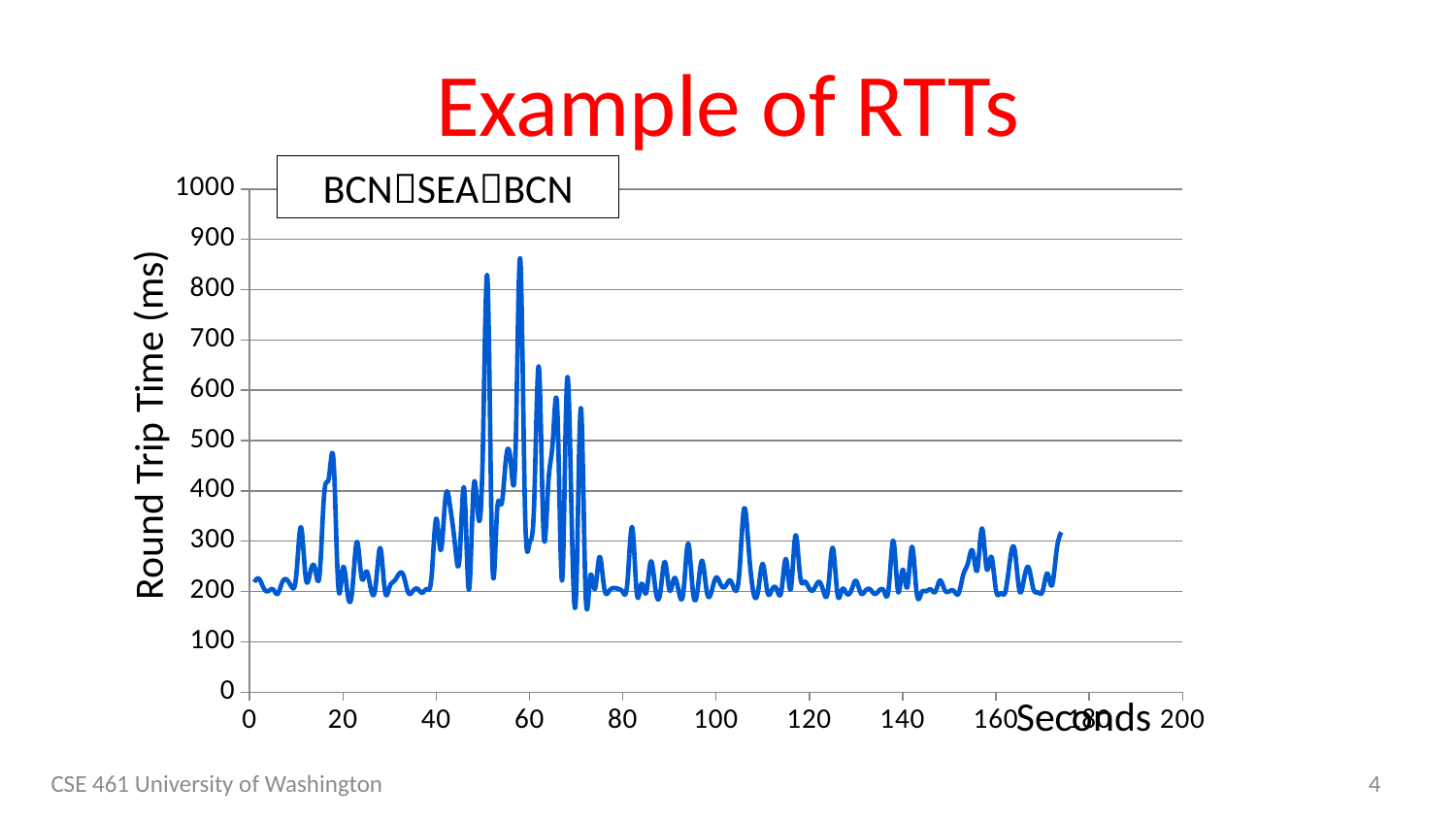
Is the highest round trip time plotted greater or less than 700? greater Is the round trip time at 140 seconds greater or less than 400? less Is the lowest round trip time plotted greater or less than 100? greater Which is larger, the round trip time at 58 seconds or the round trip time at 120 seconds? 58 seconds How many series does the legend list? 1 What is the maximum value shown on the vertical axis? 1000 What is the title of the chart on the slide? Example of RTTs What kind of chart is shown on the slide? line chart What is the label on the vertical axis? Round Trip Time (ms)